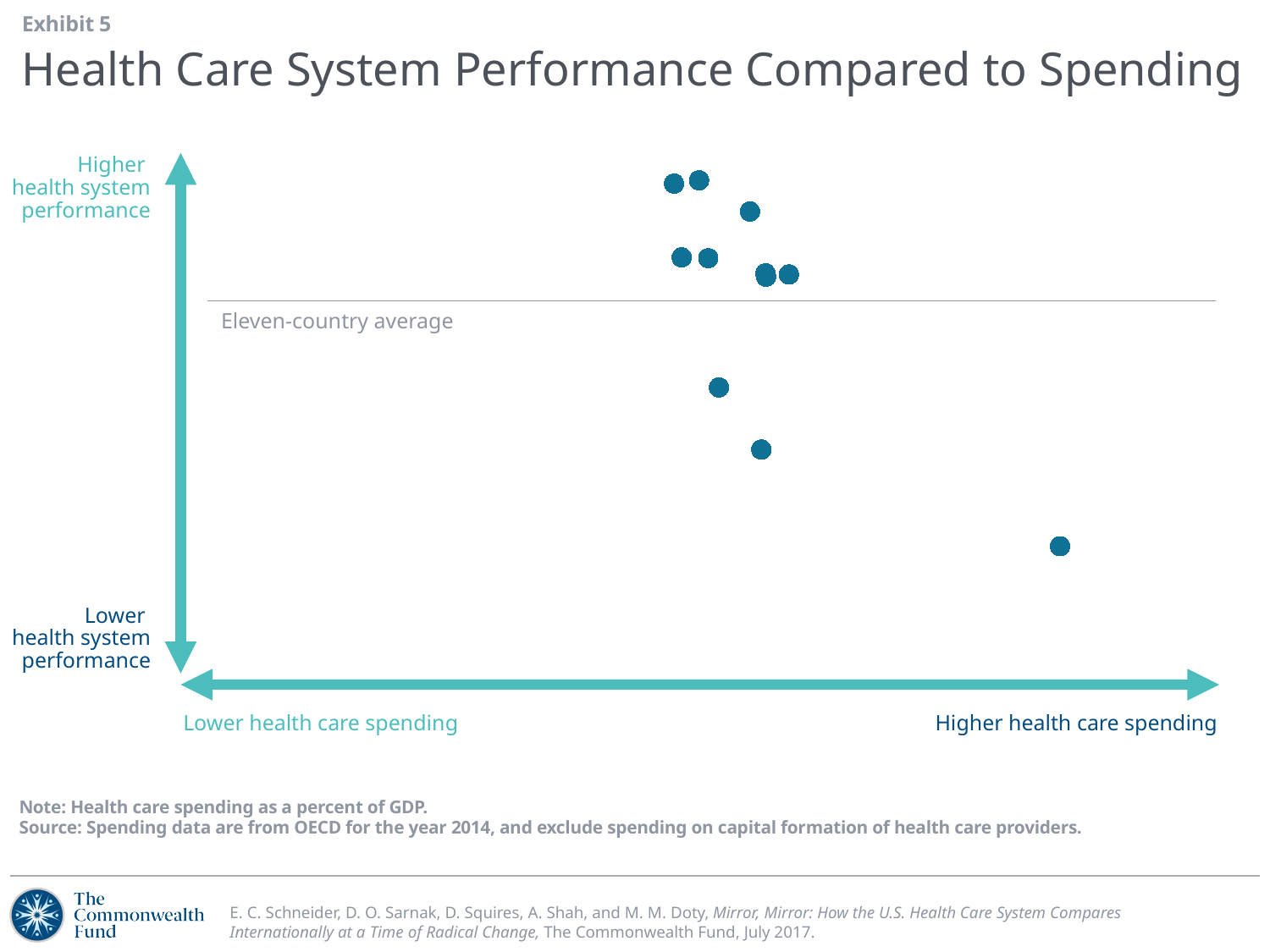
What does the horizontal grey line across the chart represent? Eleven-country average What does the vertical axis measure? Health system performance What kind of chart is shown on the slide? Scatter plot Does the point with the highest health care spending have the highest or the lowest health system performance of all the points? Lowest As health care spending increases along the x axis, does health system performance generally rise or fall? Fall Are most of the plotted points above or below the eleven-country average line? Above How many data points lie below the eleven-country average line? 3 What is the title of the chart? Health Care System Performance Compared to Spending Is the point with the highest health care spending above or below the eleven-country average line? Below